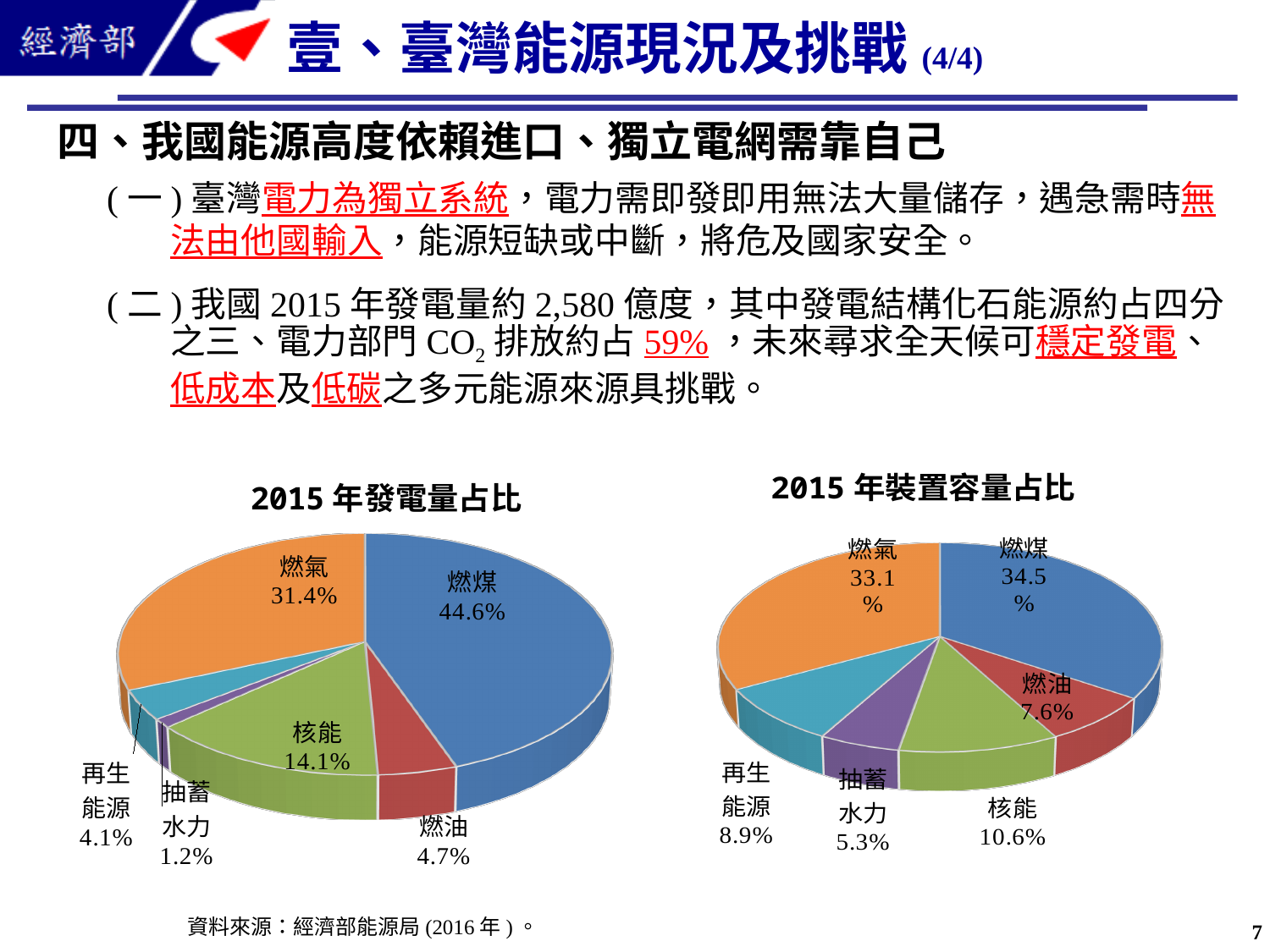
In the 2015 年裝置容量占比 chart, what is the difference between the shares of 核能 and 燃油? 3.0% In the 2015 年裝置容量占比 chart, which is larger, 再生能源 or 燃油? 再生能源 In the 2015 年發電量占比 chart, which category has the largest share? 燃煤 In the 2015 年裝置容量占比 chart, what share does 燃氣 have? 33.1% In the 2015 年發電量占比 chart, what share does 再生能源 have? 4.1% In the 2015 年裝置容量占比 chart, which category has the smallest share? 抽蓄水力 How many categories are shown in the 2015 年裝置容量占比 chart? 6 In the 2015 年發電量占比 chart, what share does 燃煤 have? 44.6% In the 2015 年發電量占比 chart, what is the difference between the shares of 燃煤 and 燃氣? 13.2% In the 2015 年發電量占比 chart, which is larger, 核能 or 燃油? 核能 What kind of chart is the 2015 年發電量占比 chart? Pie chart In the 2015 年發電量占比 chart, which category has the smallest share? 抽蓄水力